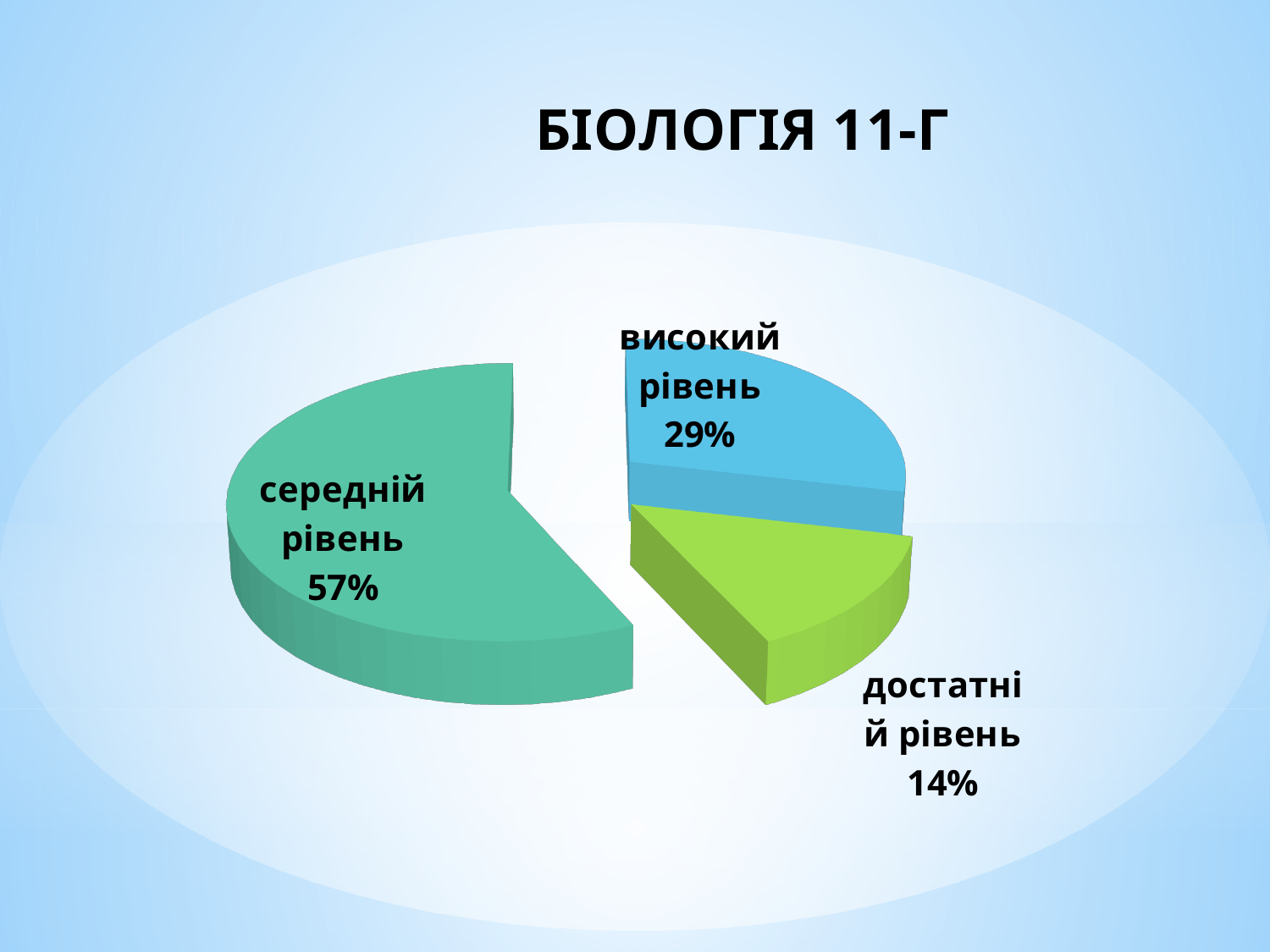
What colour is the slice for середній рівень? teal green Which level has the largest share of the pie? середній рівень What is the title of the chart? БІОЛОГІЯ 11-Г What percentage is shown for достатній рівень? 14% How many slices does the pie chart have? 3 Which is larger, the share for високий рівень or the share for достатній рівень? високий рівень What percentage is shown for середній рівень? 57% What is the difference in percentage points between високий рівень and достатній рівень? 15 What is the difference in percentage points between середній рівень and високий рівень? 28 What percentage is shown for високий рівень? 29% What kind of chart is shown on the slide? pie chart Which level has the smallest share of the pie? достатній рівень